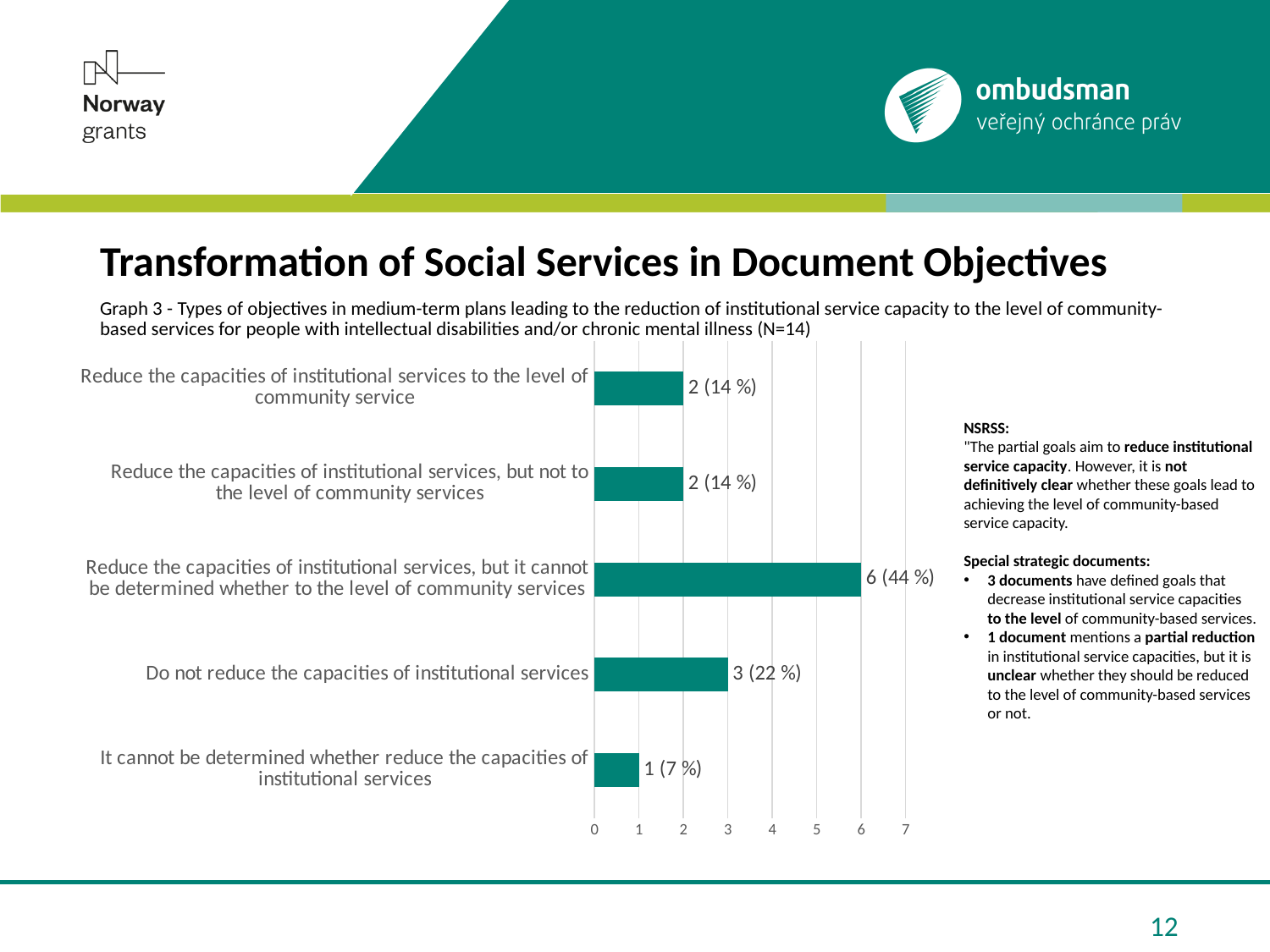
What is the value for "It cannot be determined whether reduce the capacities of institutional services"? 1 (7 %) Which category has the lowest value? It cannot be determined whether reduce the capacities of institutional services What is the maximum value shown on the horizontal axis of the chart? 7 How many categories are shown in the chart? 5 What is the value for "Reduce the capacities of institutional services, but it cannot be determined whether to the level of community services"? 6 (44 %) Is the value for "Reduce the capacities of institutional services, but it cannot be determined whether to the level of community services" greater or less than 5? greater What is the value for "Reduce the capacities of institutional services to the level of community service"? 2 (14 %) What kind of chart is shown on the slide? bar chart What is the value for "Do not reduce the capacities of institutional services"? 3 (22 %) Which category has the highest value? Reduce the capacities of institutional services, but it cannot be determined whether to the level of community services Which is larger: the value for "Do not reduce the capacities of institutional services" or the value for "Reduce the capacities of institutional services, but not to the level of community services"? Do not reduce the capacities of institutional services What is the difference in count between "Reduce the capacities of institutional services, but it cannot be determined whether to the level of community services" and "Do not reduce the capacities of institutional services"? 3